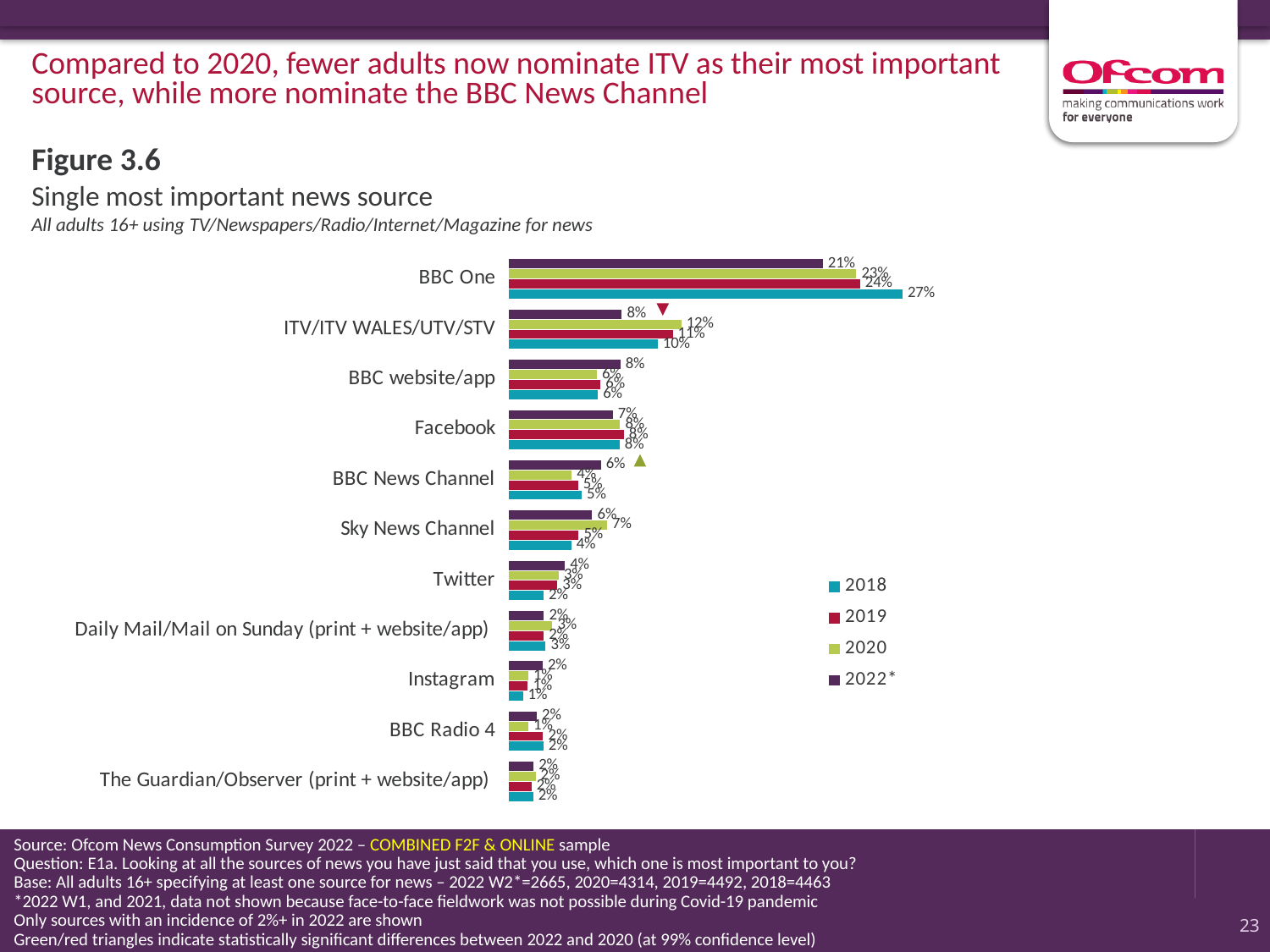
Which news source has the highest 2022* value? BBC One How many news sources (categories) are shown in the chart? 11 What type of chart is shown on the slide? Bar chart Which years are listed in the chart's legend? 2018, 2019, 2020, 2022* What percentage of adults nominated BBC One as their single most important news source in 2018? 27% What is the difference between the 2020 value (12%) and the 2022* value (8%) for ITV/ITV WALES/UTV/STV? 4 percentage points By how many percentage points did BBC One's value fall from 2018 (27%) to 2022* (21%)? 6 percentage points What is the 2022* value for BBC News Channel? 6% How many series does the legend list? 4 What is the 2022* value for ITV/ITV WALES/UTV/STV? 8% For ITV/ITV WALES/UTV/STV, which year has the larger value: 2020 or 2022*? 2020 What is the 2020 value for Sky News Channel? 7%